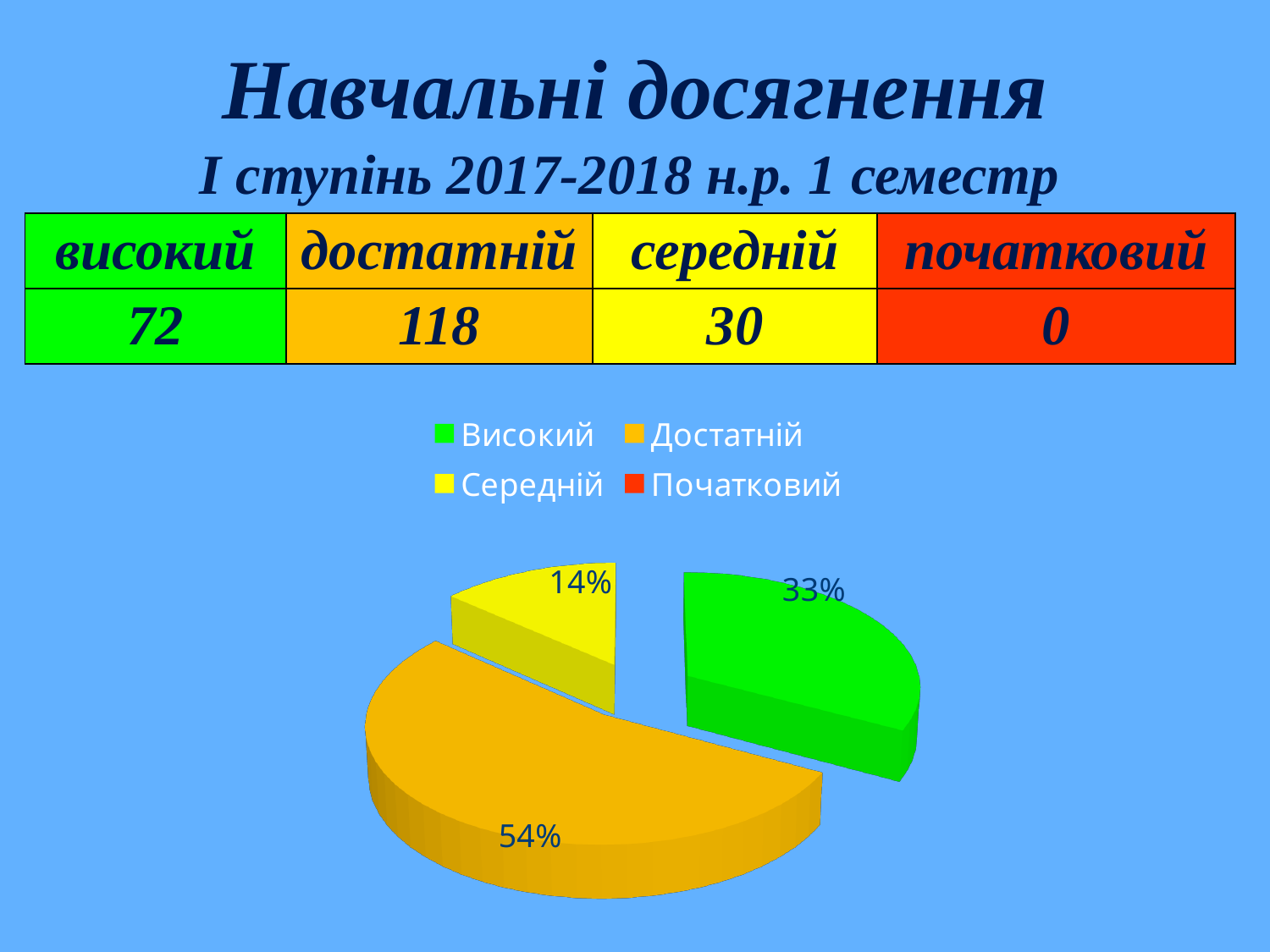
What share of the pie does the Достатній slice represent? 54% What share of the pie does the Високий slice represent? 33% How many categories does the legend of the pie chart list? 4 How many slices with percentage labels are visible in the pie chart? 3 What colour is the Достатній slice in the pie chart? orange Which slice is larger, Високий or Середній? Високий Which of the labelled slices is the smallest? Середній Which legend entry is shown in red? Початковий What share of the pie does the Середній slice represent? 14% Which category has the largest slice of the pie? Достатній By how many percentage points does the Достатній share exceed the Високий share? 21 What kind of chart is shown on the slide? pie chart